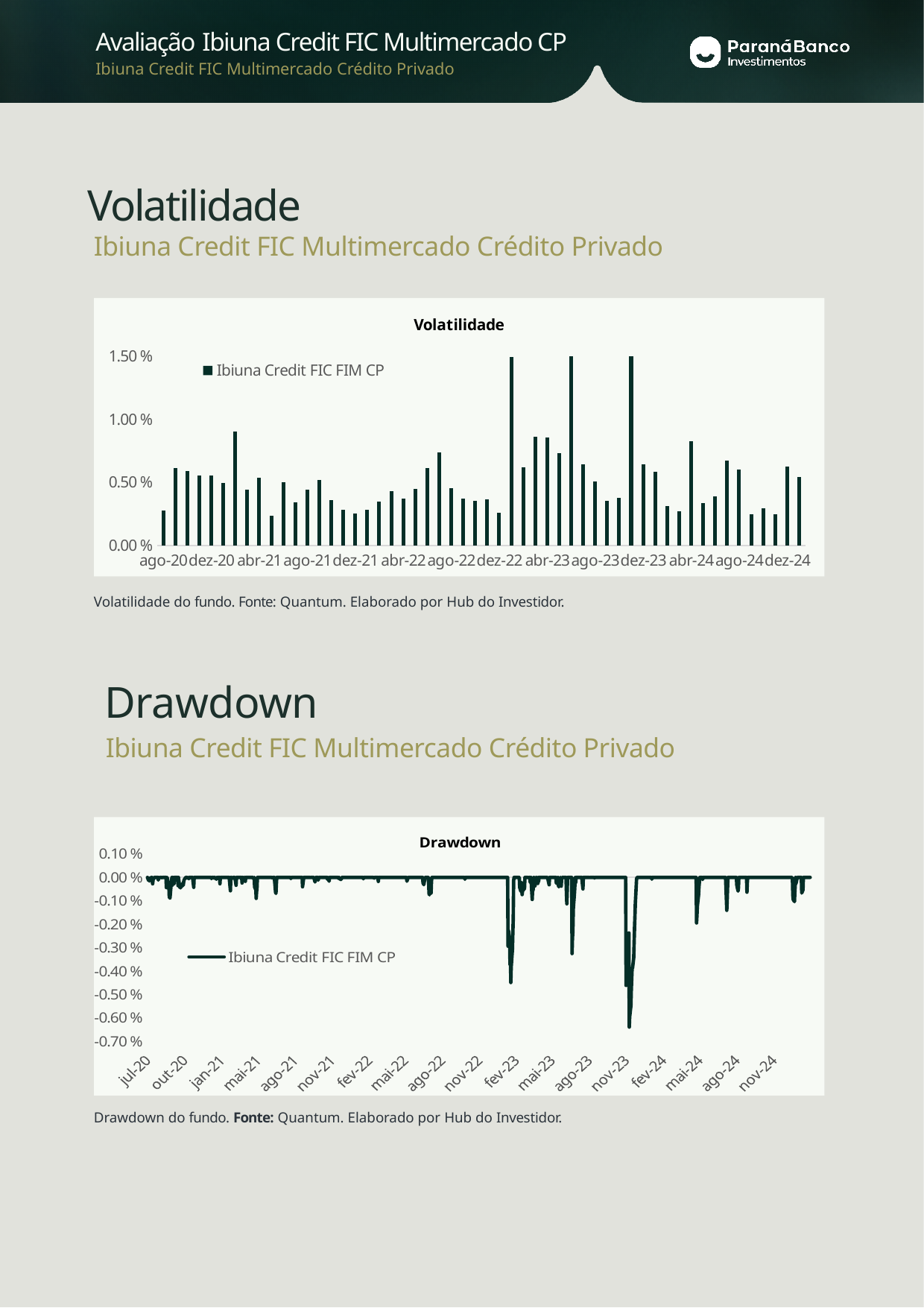
In the Volatilidade chart, is the value for ago-20 greater or less than 0.50%? less How many series does the legend of the Volatilidade chart list? 1 How many series does the legend of the Drawdown chart list? 1 What is the highest tick value shown on the y-axis of the Volatilidade chart? 1.50 % What kind of chart is the Drawdown chart? line chart In the Volatilidade chart, is the value for dez-23 greater or less than 1.00%? less What kind of chart is the Volatilidade chart? bar chart In the Volatilidade chart, what is the name of the series shown in the legend? Ibiuna Credit FIC FIM CP How many x-axis labels are shown on the Drawdown chart? 18 In the Volatilidade chart, is the value for dez-22 greater or less than 1.00%? less